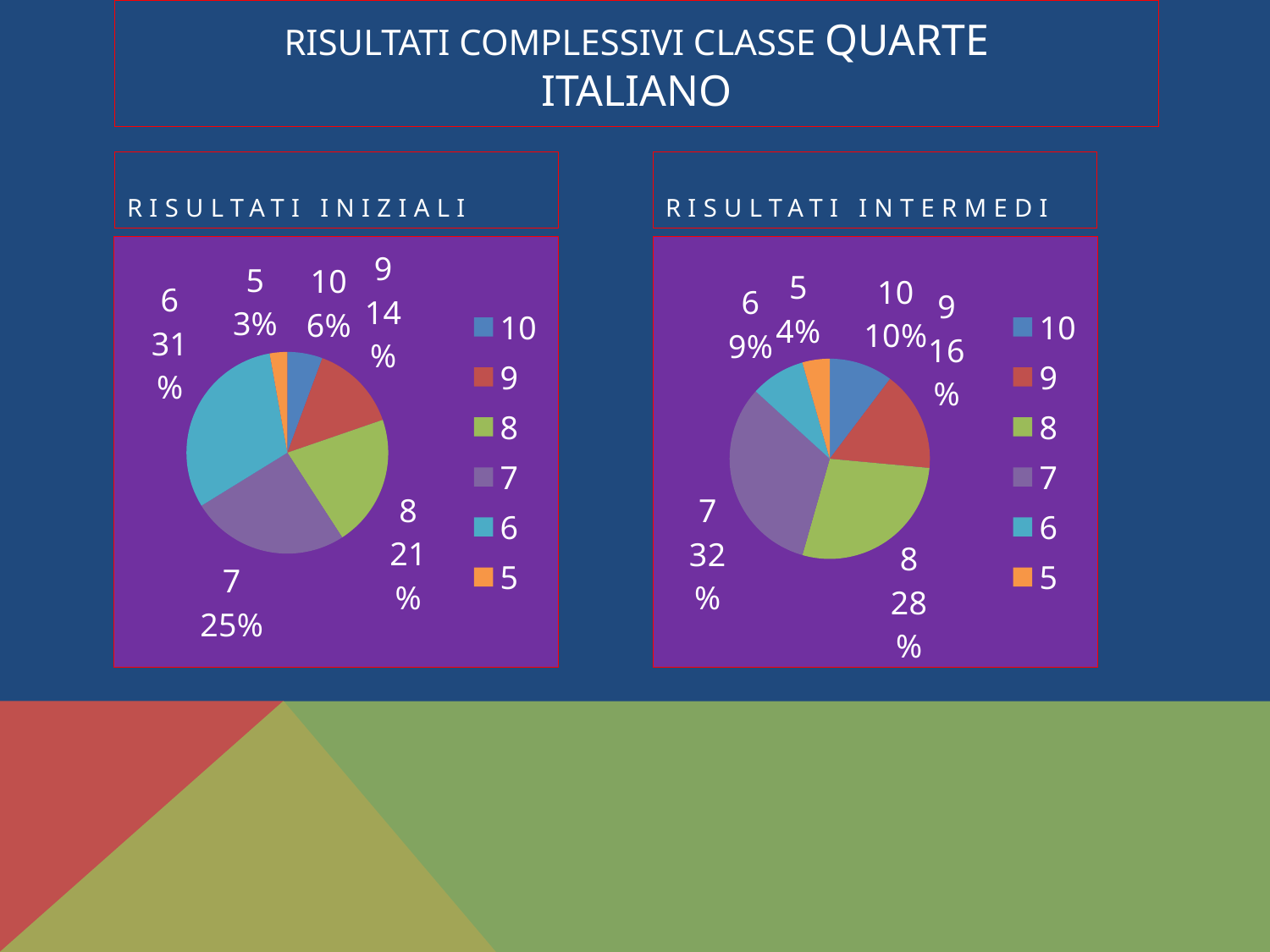
In the RISULTATI INIZIALI chart, what share does grade 6 have? 31% What type of chart is used for RISULTATI INIZIALI? Pie chart In the RISULTATI INTERMEDI chart, what share does grade 7 have? 32% In the RISULTATI INIZIALI chart, which grade has the smallest slice? 5 In the RISULTATI INIZIALI chart, which is larger: the share of grade 9 or the share of grade 10? 9 In the RISULTATI INIZIALI chart, which grade has the largest slice? 6 How many entries does the legend of the RISULTATI INTERMEDI chart list? 6 In the RISULTATI INTERMEDI chart, what share does grade 10 have? 10% In the RISULTATI INTERMEDI chart, what is the difference between the shares of grade 7 and grade 8? 4% How many slices does the RISULTATI INTERMEDI pie chart have? 6 In the RISULTATI INTERMEDI chart, which grade has the smallest slice? 5 In the RISULTATI INIZIALI chart, what share does grade 8 have? 21%